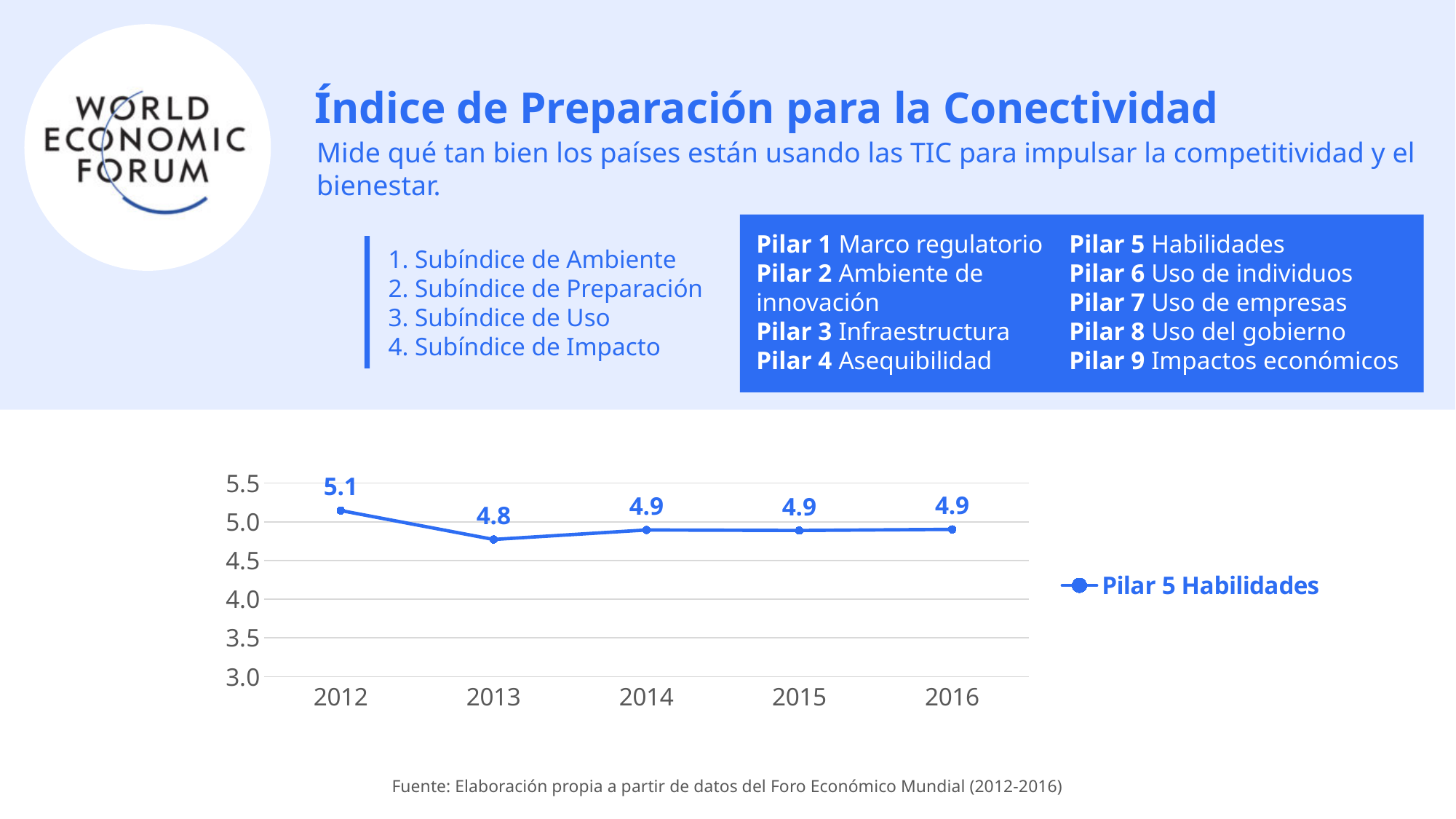
What kind of chart is shown on the slide? line chart What is the value for Pilar 5 Habilidades in 2016? 4.9 Which year has the lowest value for Pilar 5 Habilidades? 2013 What is the difference between the 2012 and 2013 values for Pilar 5 Habilidades? 0.3 How many series does the legend list? 1 Which year has the highest value for Pilar 5 Habilidades? 2012 Which is larger, the value for 2012 or the value for 2014? 2012 What is the value for Pilar 5 Habilidades in 2013? 4.8 How many years are plotted on the chart? 5 What is the name of the series shown in the legend? Pilar 5 Habilidades What is the value for Pilar 5 Habilidades in 2012? 5.1 Is the value for 2013 greater or less than 5.0? less